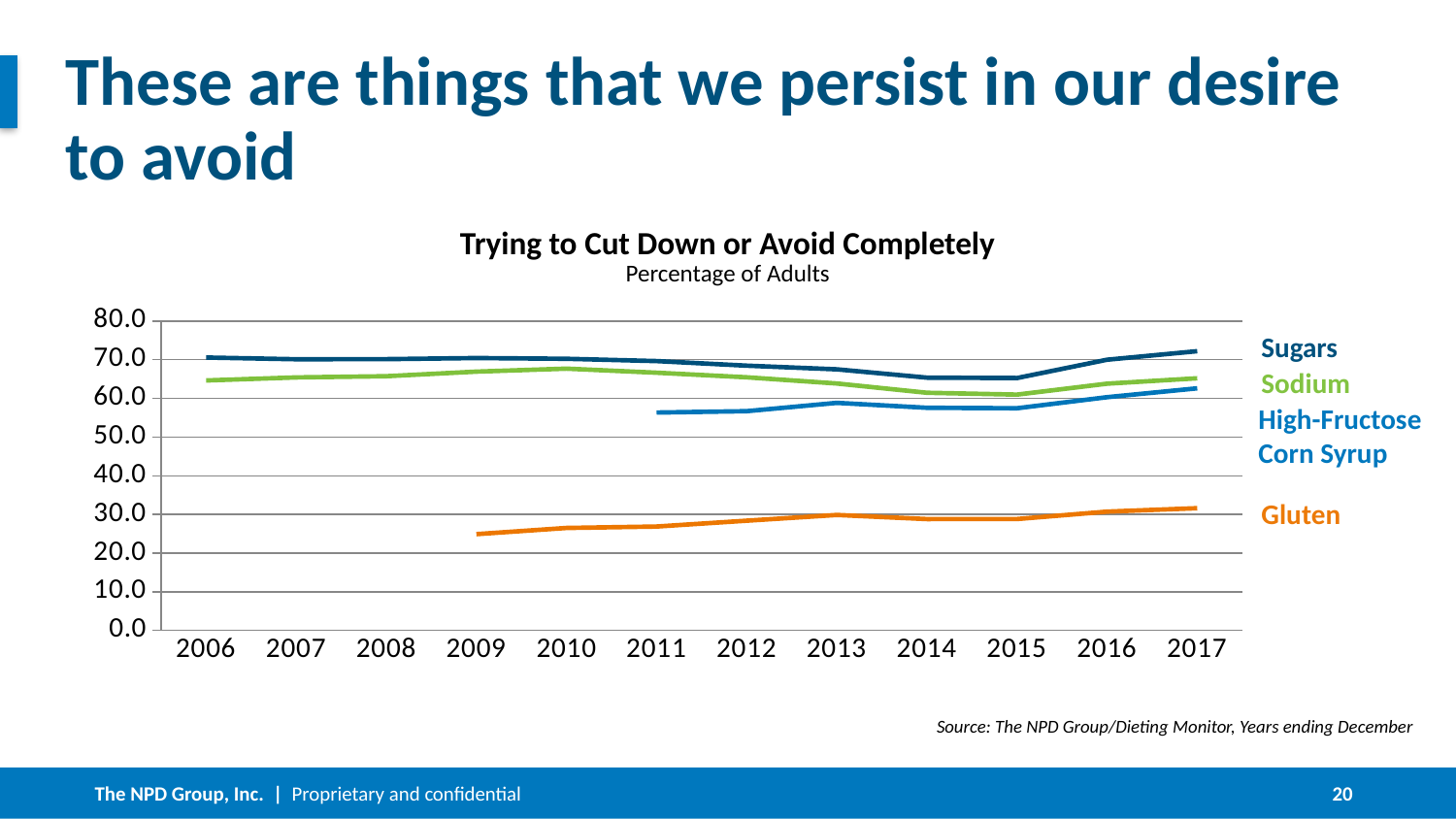
In 2010, which is larger: the value for Sugars or the value for Sodium? Sugars Is the value for Sodium in 2006 greater or less than 60.0? greater How many years are shown on the x axis of the chart? 12 How many series are plotted in the chart? 4 What is the title of the chart? Trying to Cut Down or Avoid Completely Is the value for High-Fructose Corn Syrup in 2011 greater or less than 50.0? greater Which series has the lowest values across the chart? Gluten In 2013, which is larger: the value for High-Fructose Corn Syrup or the value for Gluten? High-Fructose Corn Syrup Which series has the highest values across the chart? Sugars Does the Gluten line generally rise or fall from 2009 to 2017? rise Is the value for Gluten in 2009 greater or less than 30.0? less What kind of chart is shown on the slide? line chart